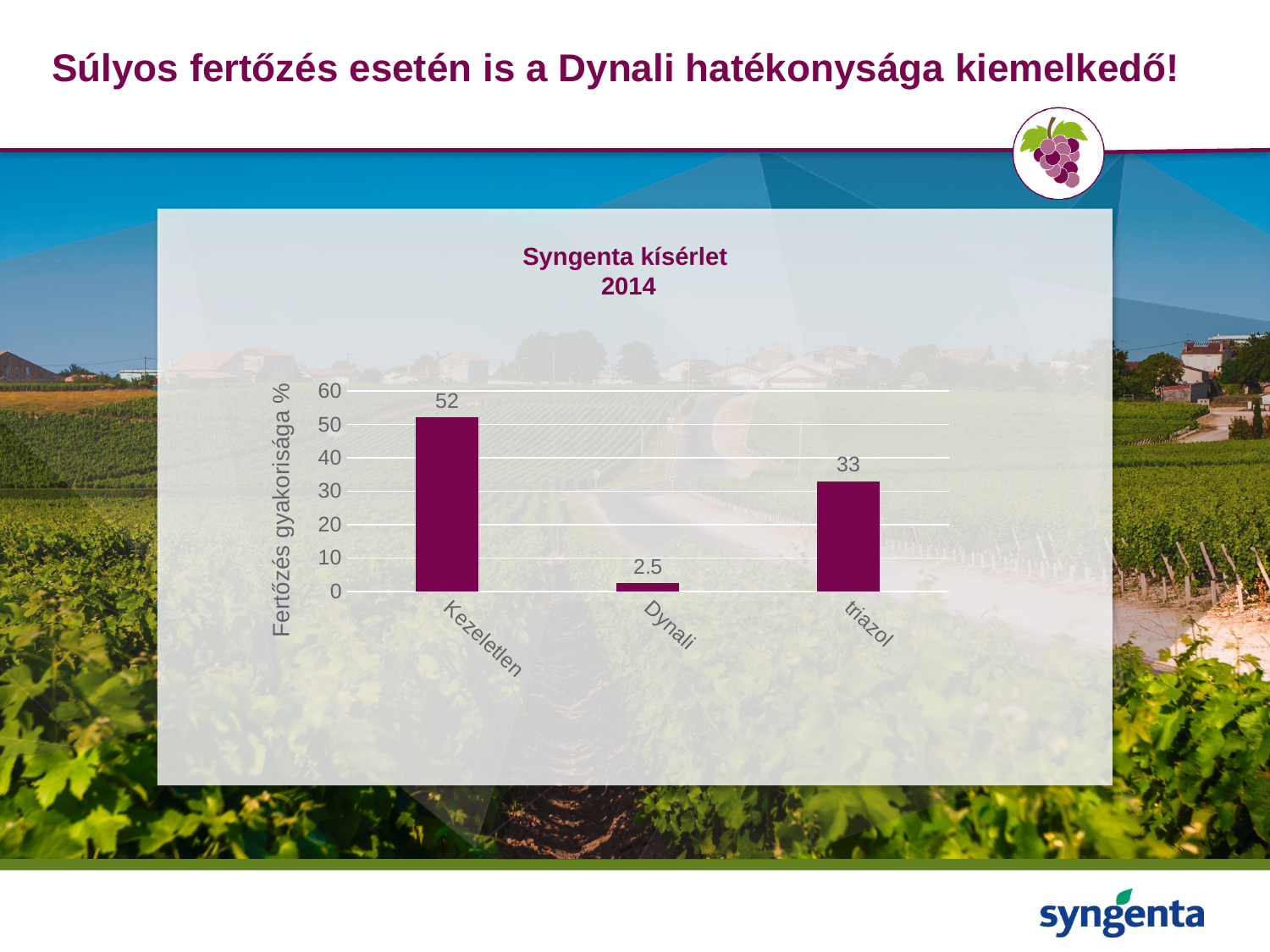
What is the difference between the values for Kezeletlen and triazol? 19 Which category has the highest value? Kezeletlen Which is larger, the value for triazol or the value for Dynali? triazol Which category has the lowest value? Dynali Is the value for triazol greater or less than 40? less What is the difference between the values for triazol and Dynali? 30.5 What is the value for Kezeletlen? 52 How many categories are shown on the x axis? 3 What is the value for triazol? 33 What is the value for Dynali? 2.5 What is the title of the chart? Syngenta kísérlet 2014 What kind of chart is shown on the slide? bar chart